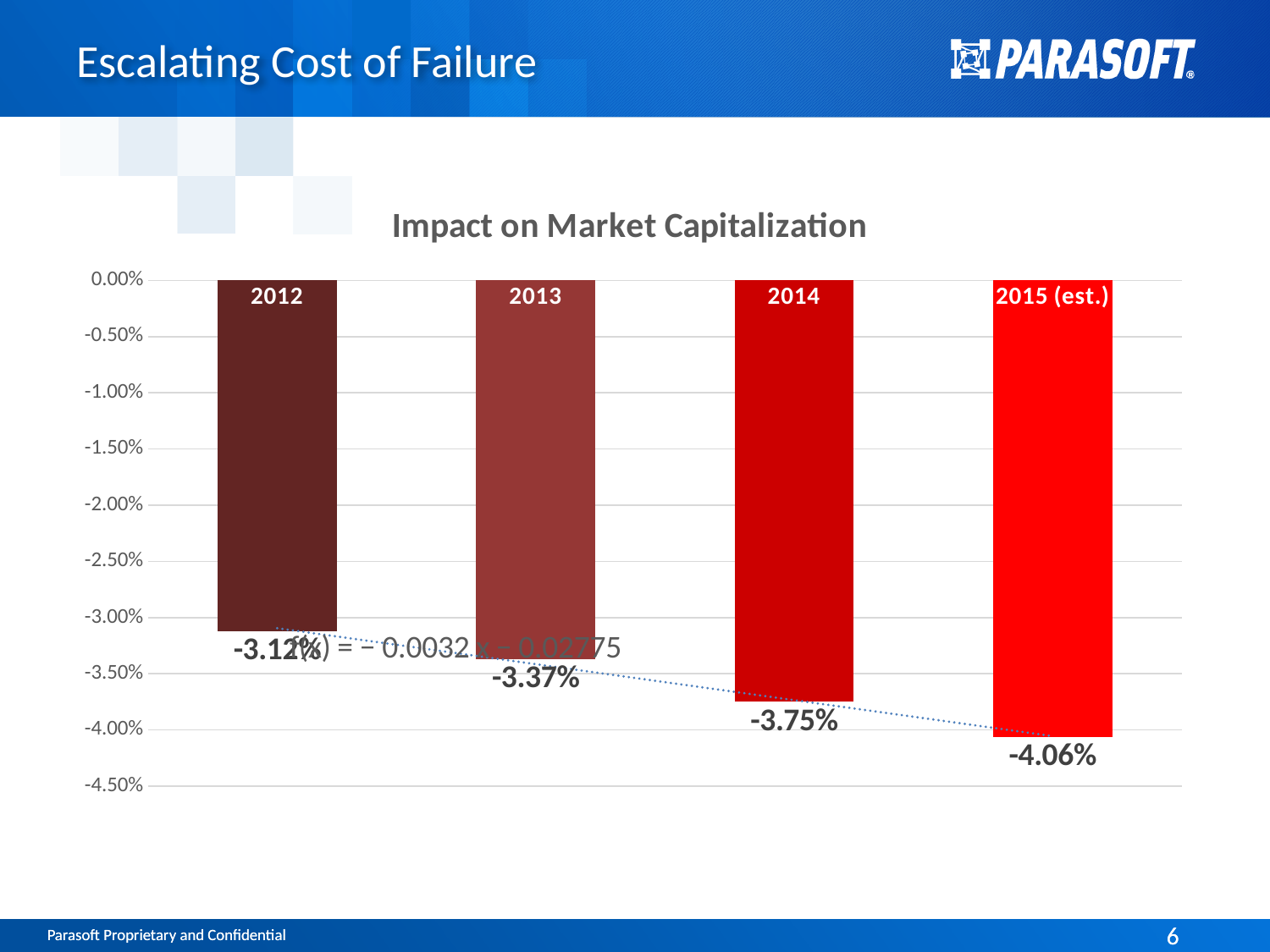
What is the value for 2015 (est.)? -4.06% What is the value for 2013? -3.37% Which year has the highest (least negative) value? 2012 Do the values rise or fall from 2012 to 2015 (est.)? fall What is the title of the chart? Impact on Market Capitalization What kind of chart is shown on the slide? bar chart Which year has the lowest (most negative) value? 2015 (est.) What is the value for 2012? -3.12% How many years are shown on the x axis? 4 What is the difference between the values for 2012 and 2015 (est.)? 0.94% Is the value for 2014 greater or less than -3.50%? less What is the value for 2014? -3.75%